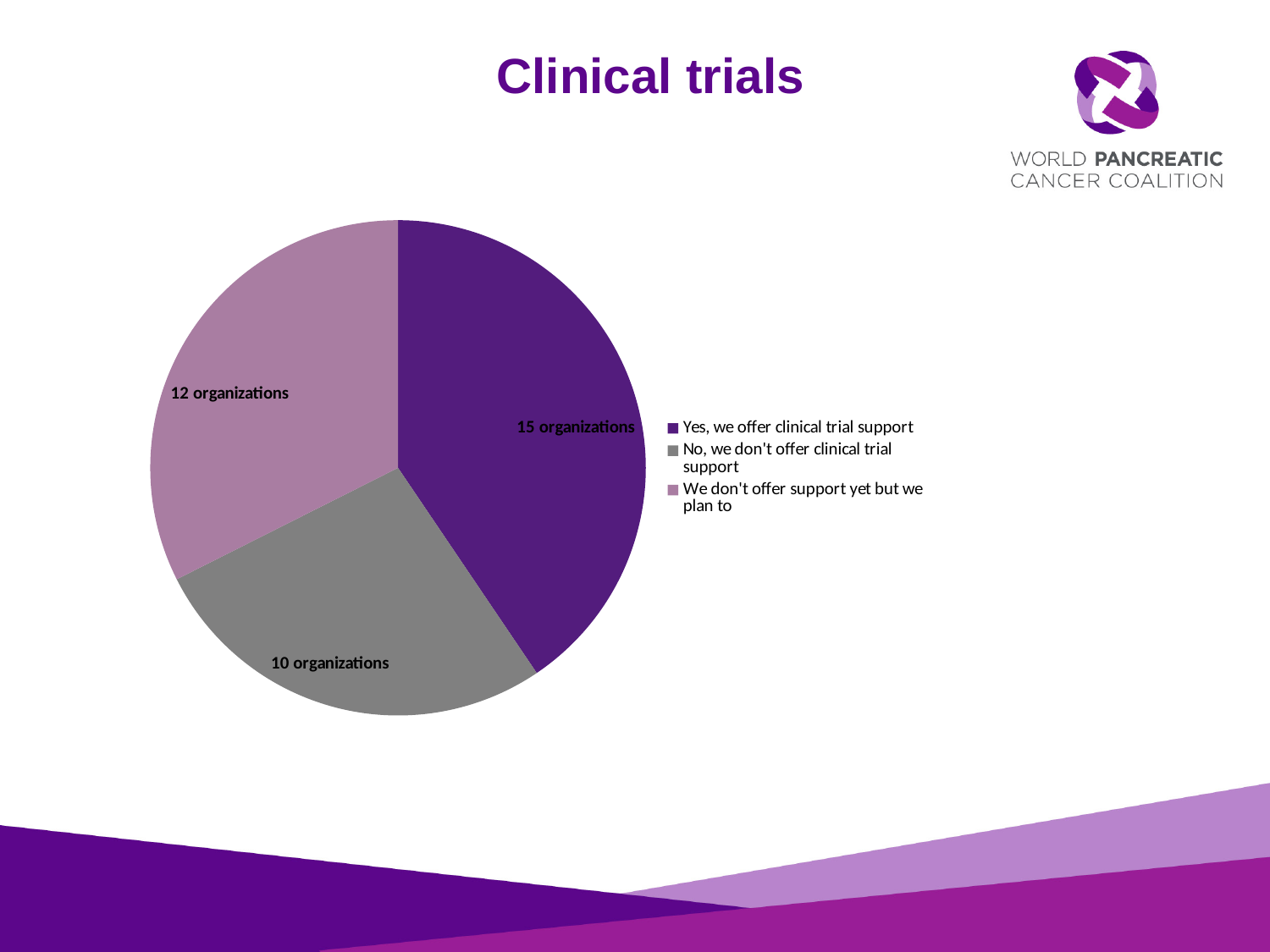
What kind of chart is shown on the slide? Pie chart What is the title of the slide containing the pie chart? Clinical trials Which response has the smallest slice of the pie? No, we don't offer clinical trial support Which response has the largest slice of the pie? Yes, we offer clinical trial support What is the total number of organizations represented in the pie chart? 37 organizations How many slices does the pie chart have? 3 What is the difference between the number of organizations that plan to offer support and those that don't offer it? 2 organizations How many more organizations offer clinical trial support than do not offer it? 5 organizations How many organizations answered "Yes, we offer clinical trial support"? 15 organizations Which is larger: the number of organizations that plan to offer support or the number that already offer it? The number that already offer it How many organizations answered "We don't offer support yet but we plan to"? 12 organizations How many organizations answered "No, we don't offer clinical trial support"? 10 organizations